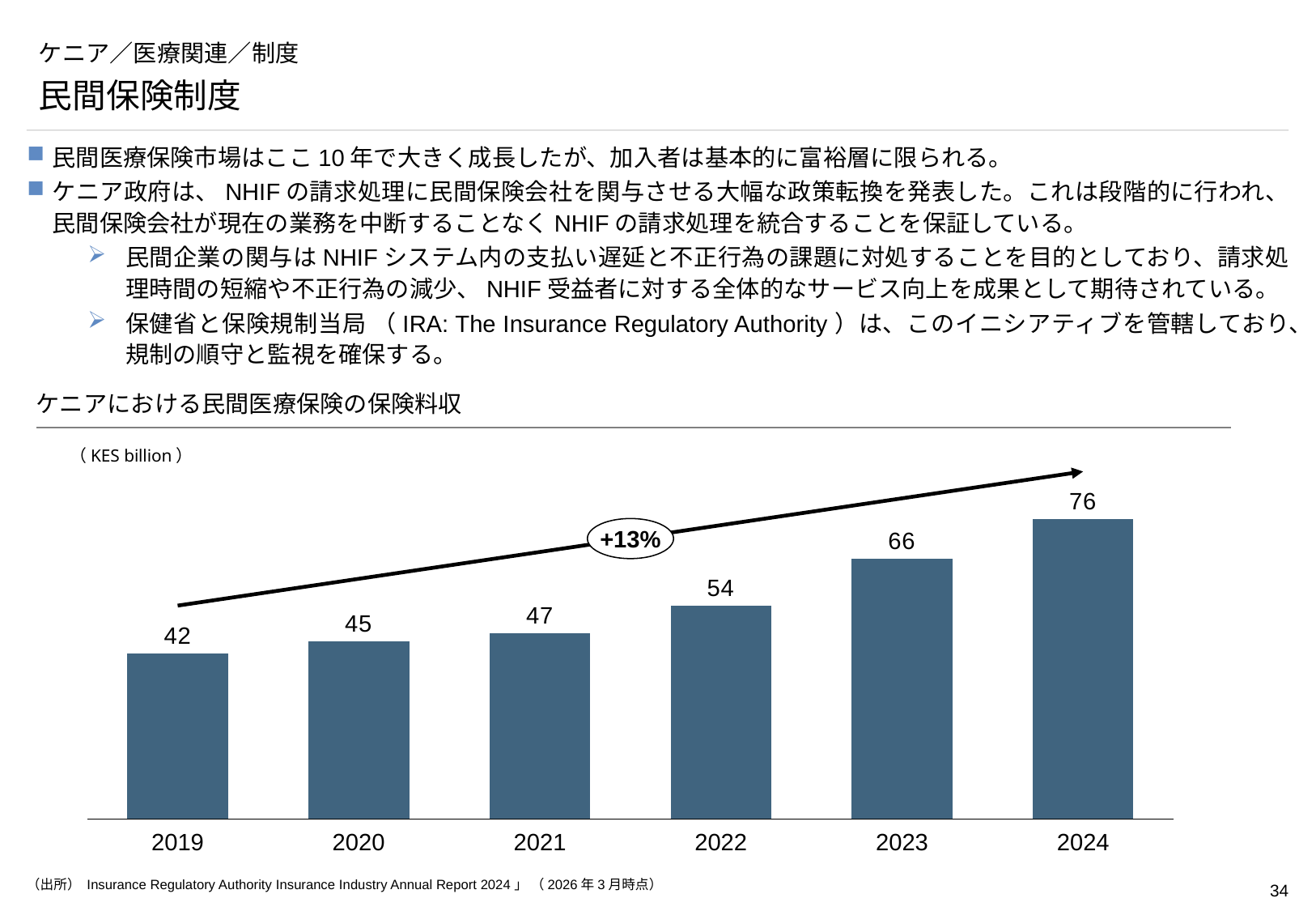
How many years are shown on the x axis? 6 What is the value for 2019? 42 Do the values rise or fall from 2019 to 2024? rise Which year has the lowest value? 2019 What kind of chart is this? bar chart What is the difference between the values for 2023 and 2022? 12 What is the value for 2022? 54 Which is larger, the value for 2021 or the value for 2020? 2021 What is the difference between the values for 2024 and 2019? 34 What growth rate is shown in the label on the arrow above the bars? +13% What is the value for 2024? 76 Which year has the highest value? 2024